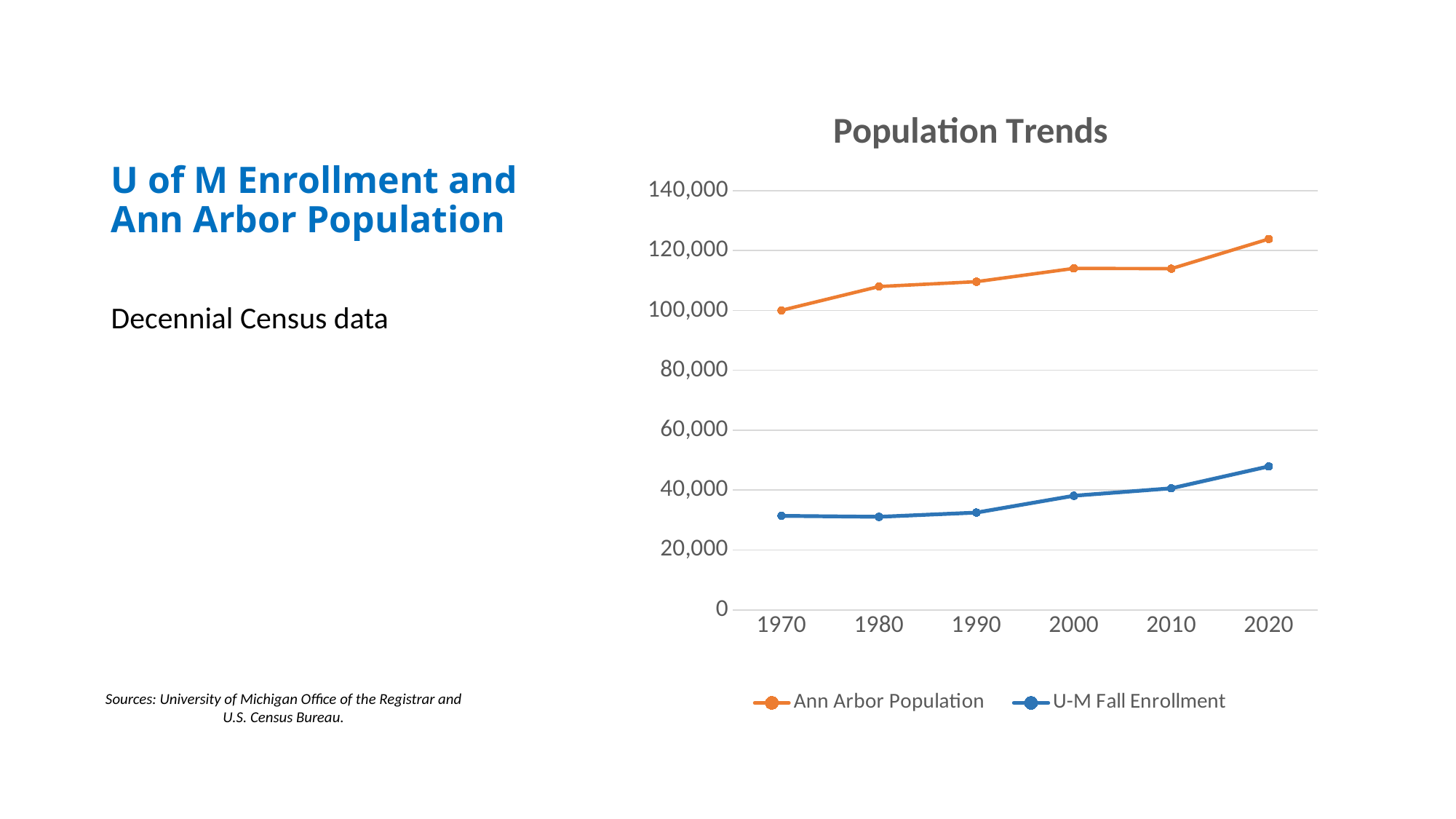
In which year is the Ann Arbor Population highest? 2020 How many years are plotted along the x axis of the Population Trends chart? 6 Is the U-M Fall Enrollment value for 1980 greater or less than 40,000? less How many series does the legend of the Population Trends chart list? 2 What kind of chart is shown on the slide? line chart Is the U-M Fall Enrollment value for 2020 greater or less than 40,000? greater In which year is the Ann Arbor Population lowest? 1970 What is the title of the chart? Population Trends In 2000, which is larger: Ann Arbor Population or U-M Fall Enrollment? Ann Arbor Population Is the Ann Arbor Population value for 1990 greater or less than 100,000? greater Does the Ann Arbor Population line generally rise or fall from 1970 to 2020? rise